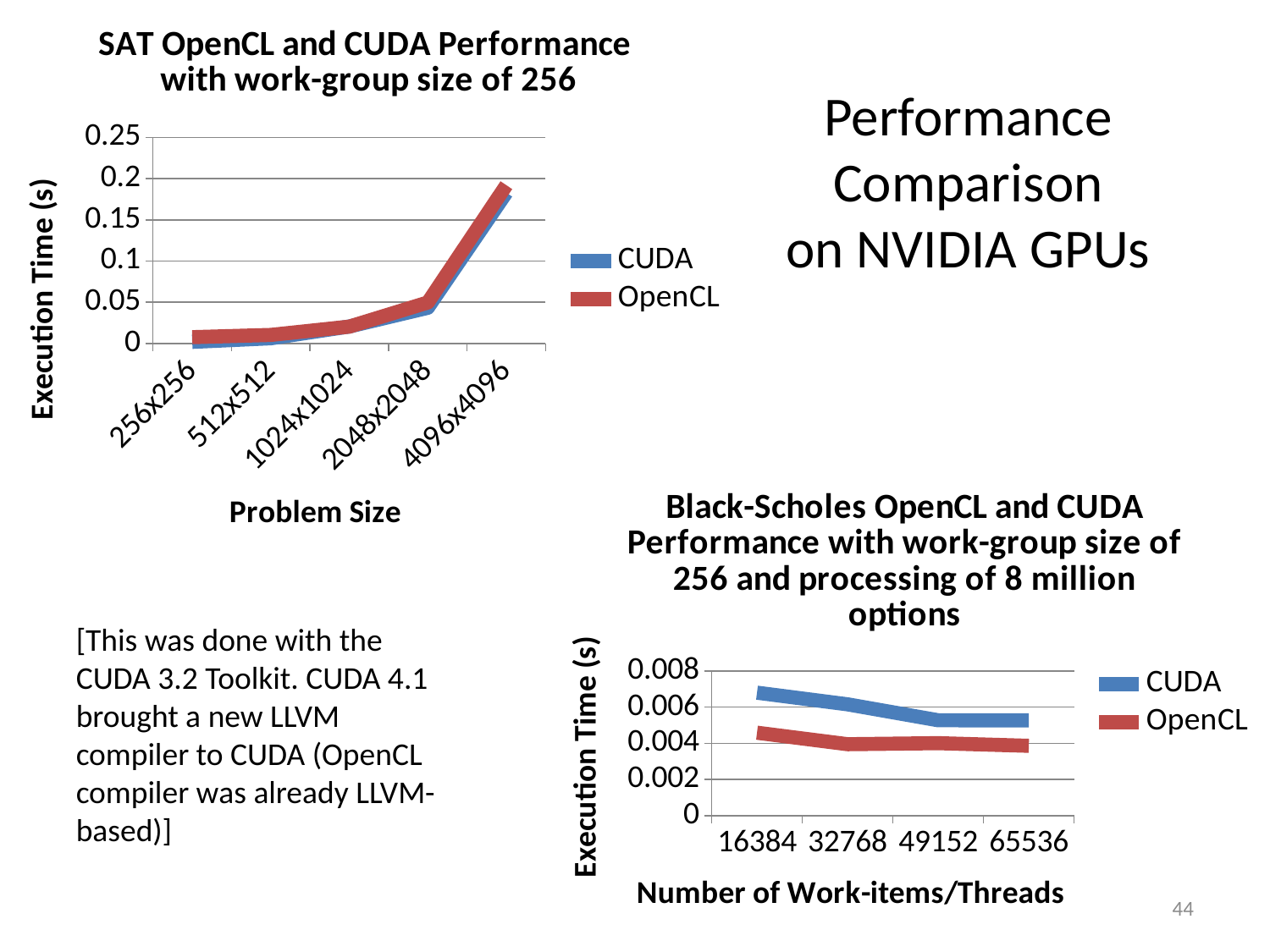
In the 'Black-Scholes OpenCL and CUDA Performance' chart, how many x-axis categories are plotted? 4 In the 'Black-Scholes OpenCL and CUDA Performance' chart, does the CUDA execution time rise or fall as the number of work-items increases? Fall In the 'SAT OpenCL and CUDA Performance with work-group size of 256' chart, do the execution times rise or fall as the problem size increases? Rise In the 'SAT OpenCL and CUDA Performance with work-group size of 256' chart, what kind of chart is shown? Line chart In the 'Black-Scholes OpenCL and CUDA Performance' chart, which series has the larger execution time at 16384 work-items: CUDA or OpenCL? CUDA In the 'SAT OpenCL and CUDA Performance with work-group size of 256' chart, how many problem sizes are plotted on the x axis? 5 In the 'SAT OpenCL and CUDA Performance with work-group size of 256' chart, is the OpenCL execution time at 4096x4096 greater or less than 0.15? greater In the 'SAT OpenCL and CUDA Performance with work-group size of 256' chart, is the CUDA execution time at 2048x2048 greater or less than 0.1? less In the 'SAT OpenCL and CUDA Performance with work-group size of 256' chart, which problem size has the highest OpenCL execution time? 4096x4096 In the 'Black-Scholes OpenCL and CUDA Performance' chart, is the CUDA execution time at 16384 greater or less than 0.006? greater In the 'Black-Scholes OpenCL and CUDA Performance' chart, what is the x-axis title? Number of Work-items/Threads In the 'SAT OpenCL and CUDA Performance with work-group size of 256' chart, how many series does the legend list? 2